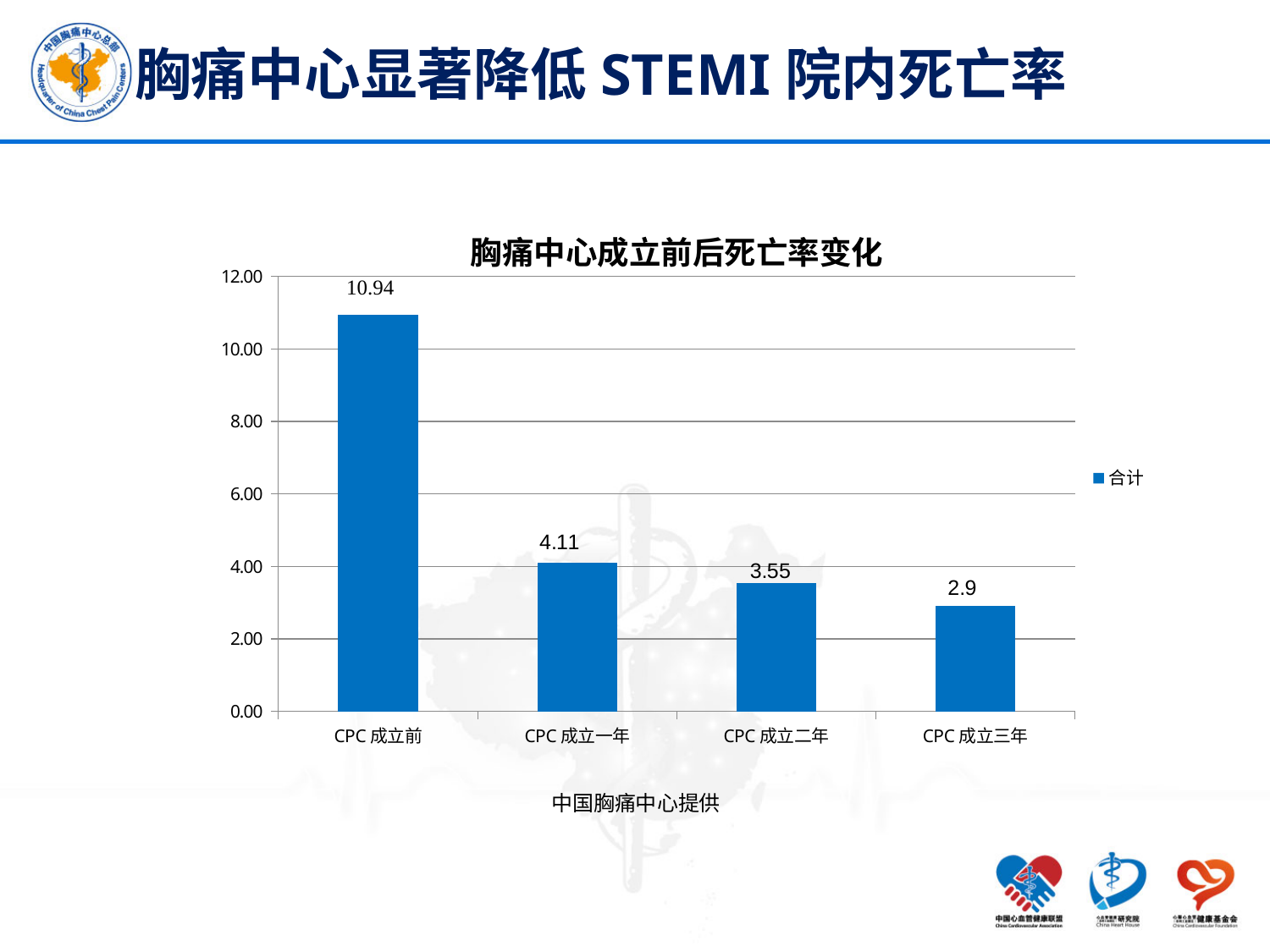
Do the values rise or fall from left to right along the x axis? fall How many categories are shown on the x axis? 4 What is the value for CPC 成立前? 10.94 What is the value for CPC 成立二年? 3.55 What is the value for CPC 成立三年? 2.9 What kind of chart is shown? bar chart Which category has the highest value? CPC 成立前 What is the value for CPC 成立一年? 4.11 How many series does the legend list? 1 Which is larger, the value for CPC 成立二年 or CPC 成立三年? CPC 成立二年 What is the difference between the values for CPC 成立前 and CPC 成立一年? 6.83 Which category has the lowest value? CPC 成立三年